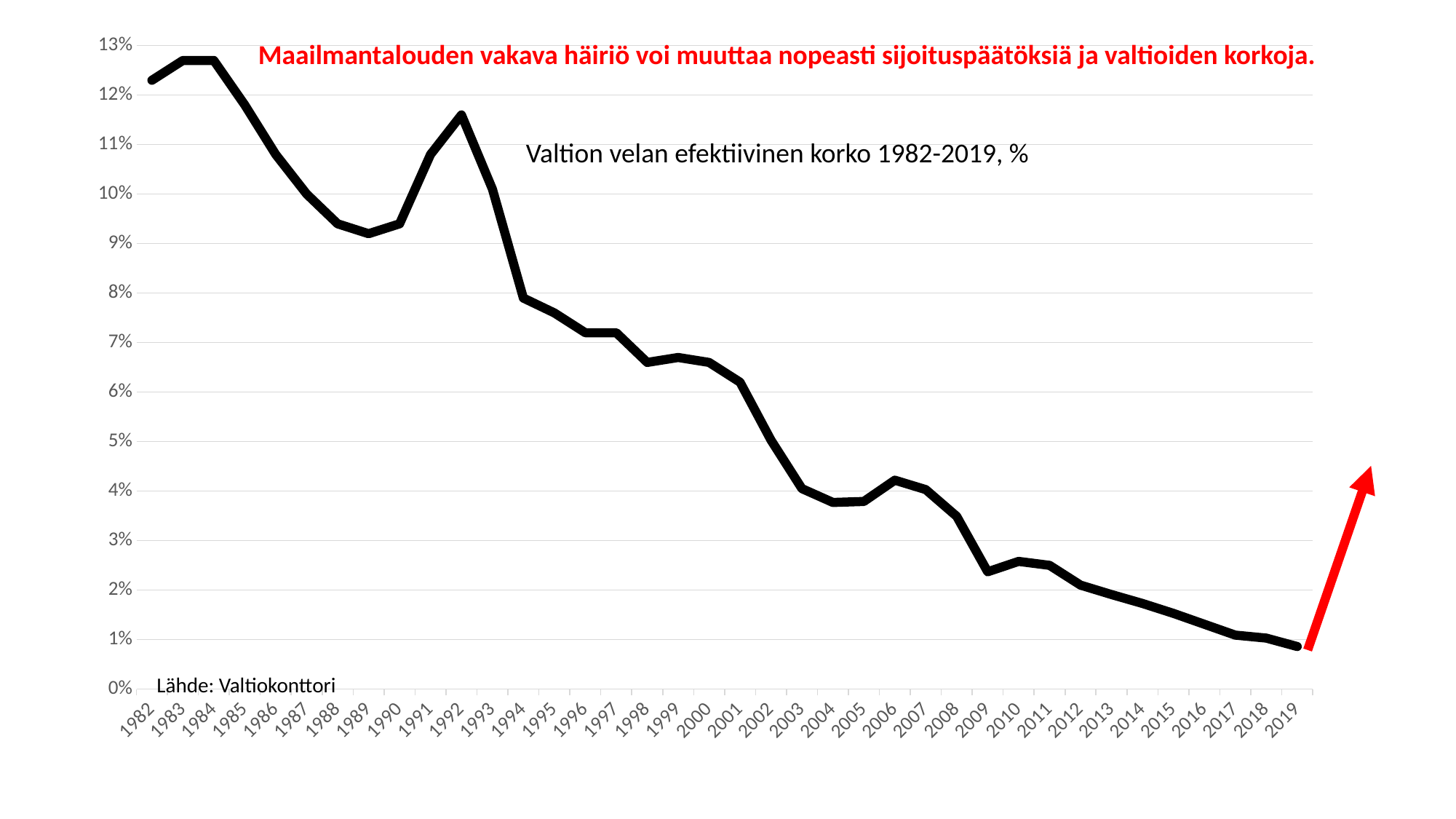
Is the value for 2019 greater or less than 1%? less What kind of chart is shown on the slide? line chart Is the value for 1982 greater or less than 12%? greater Is the value for 1992 greater or less than 11%? greater Overall, do the values rise or fall from 1982 to 2019? fall Which year has the lowest value on the chart? 2019 How many years are plotted on the x axis of the chart? 38 What is the title of the chart? Valtion velan efektiivinen korko 1982-2019, % Which year has the larger value, 1992 or 1994? 1992 What source is cited for the chart data? Valtiokonttori